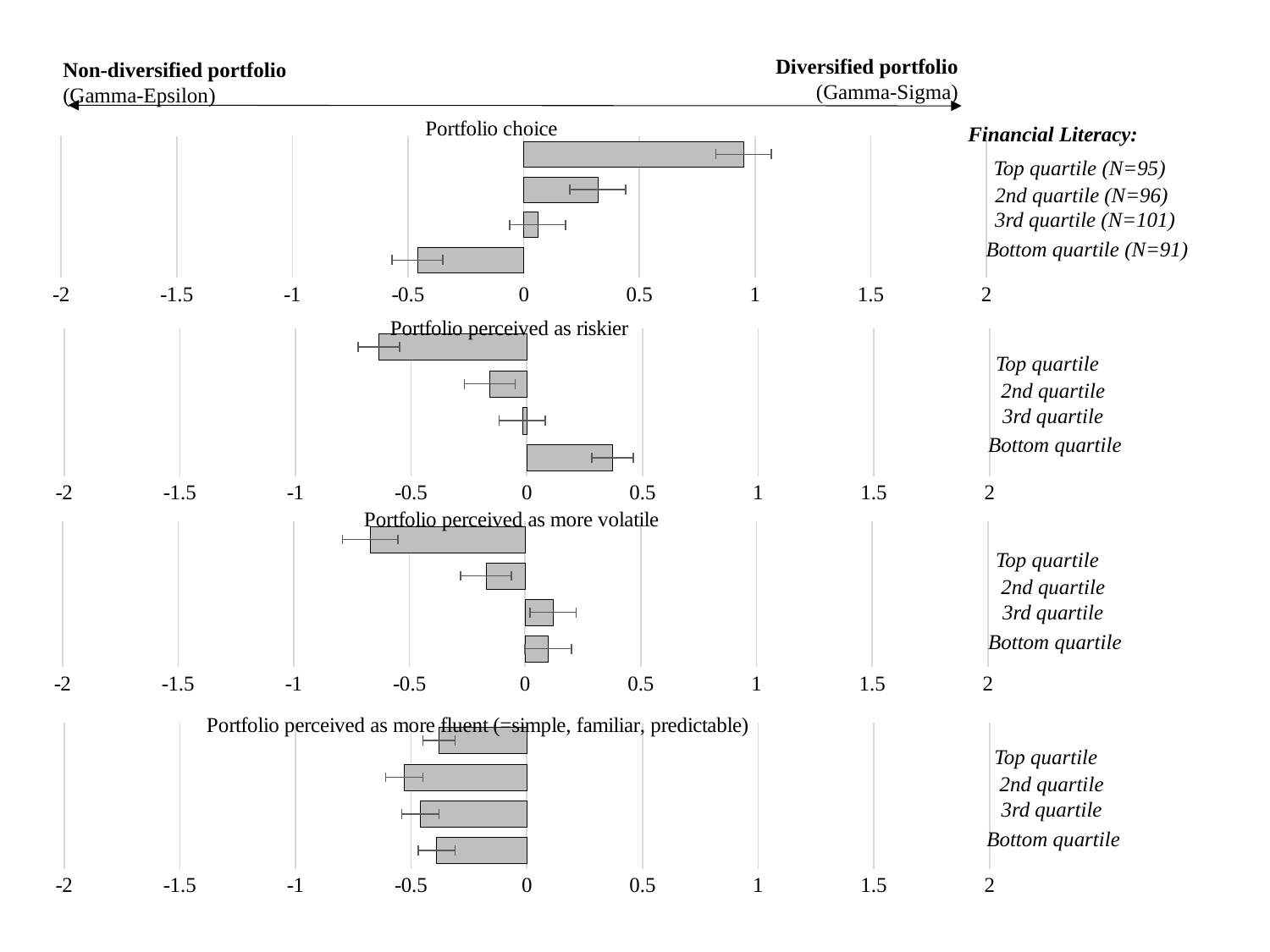
In the "Portfolio perceived as more fluent (=simple, familiar, predictable)" chart, how many bars have negative values? 4 In the "Portfolio perceived as riskier" chart, which quartile has the lowest value? Top quartile In the "Portfolio perceived as riskier" chart, is the value for the Top quartile greater or less than -0.5? less In the "Portfolio choice" chart, is the value for the Top quartile greater or less than 0.5? greater In the "Portfolio choice" chart, which quartile has the lowest value? Bottom quartile How many charts are shown on the slide? 4 In the "Portfolio perceived as more volatile" chart, which quartile has the lowest value? Top quartile In the "Portfolio perceived as riskier" chart, which is larger, the value for the Bottom quartile or the value for the 2nd quartile? Bottom quartile In the "Portfolio choice" chart, which quartile has the highest value? Top quartile What kind of chart is the "Portfolio choice" chart? bar chart In the "Portfolio choice" chart, how many bars are plotted? 4